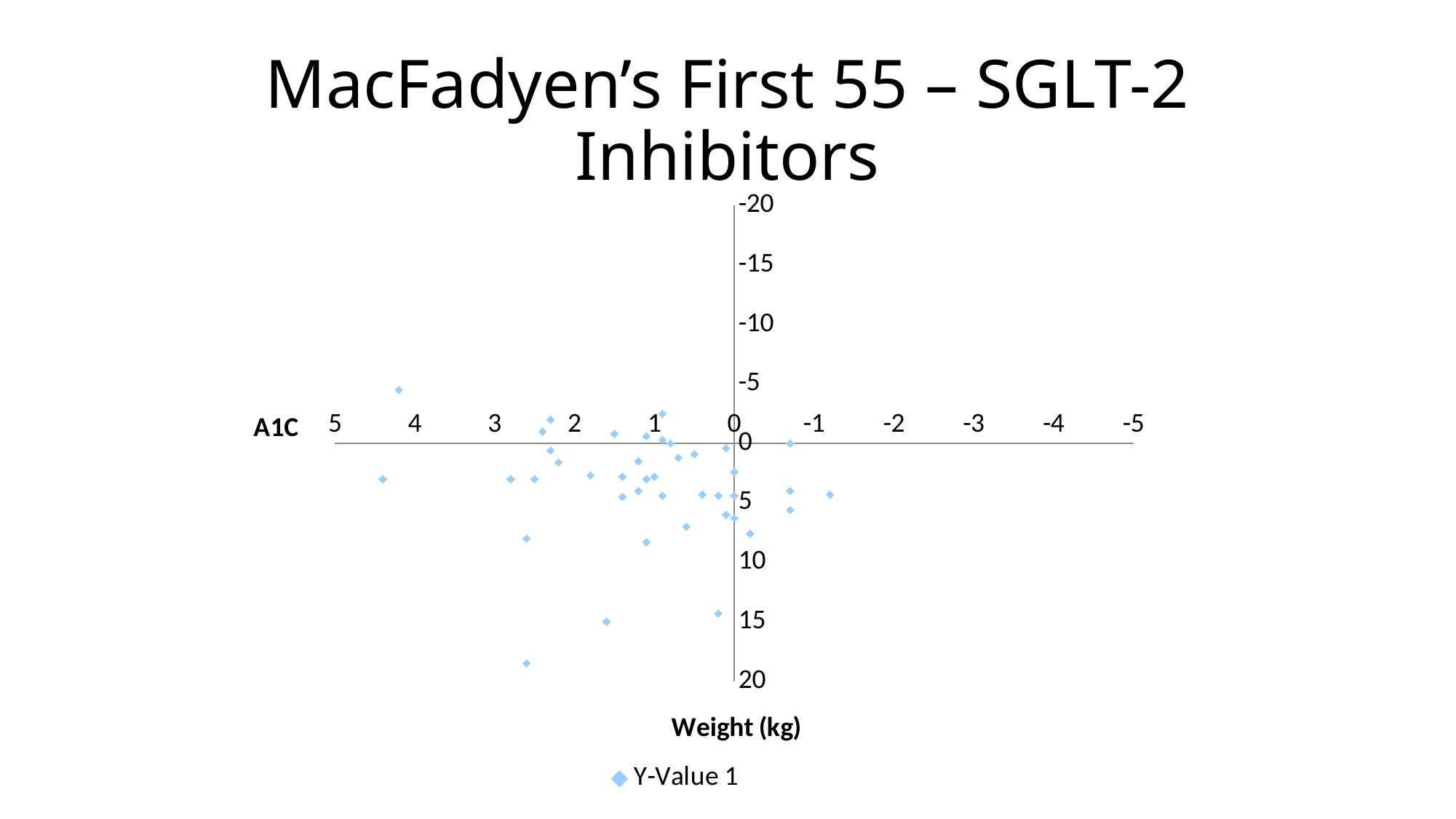
What is the name of the series shown in the legend? Y-Value 1 How many series does the legend list? 1 Is the smallest (most negative) A1C value plotted greater or less than -2? greater Is the largest Weight (kg) value plotted greater or less than 15? greater Is the largest A1C value plotted greater or less than 4? greater What is the title of the chart? MacFadyen's First 55 – SGLT-2 Inhibitors What kind of chart is shown on the slide? scatter chart